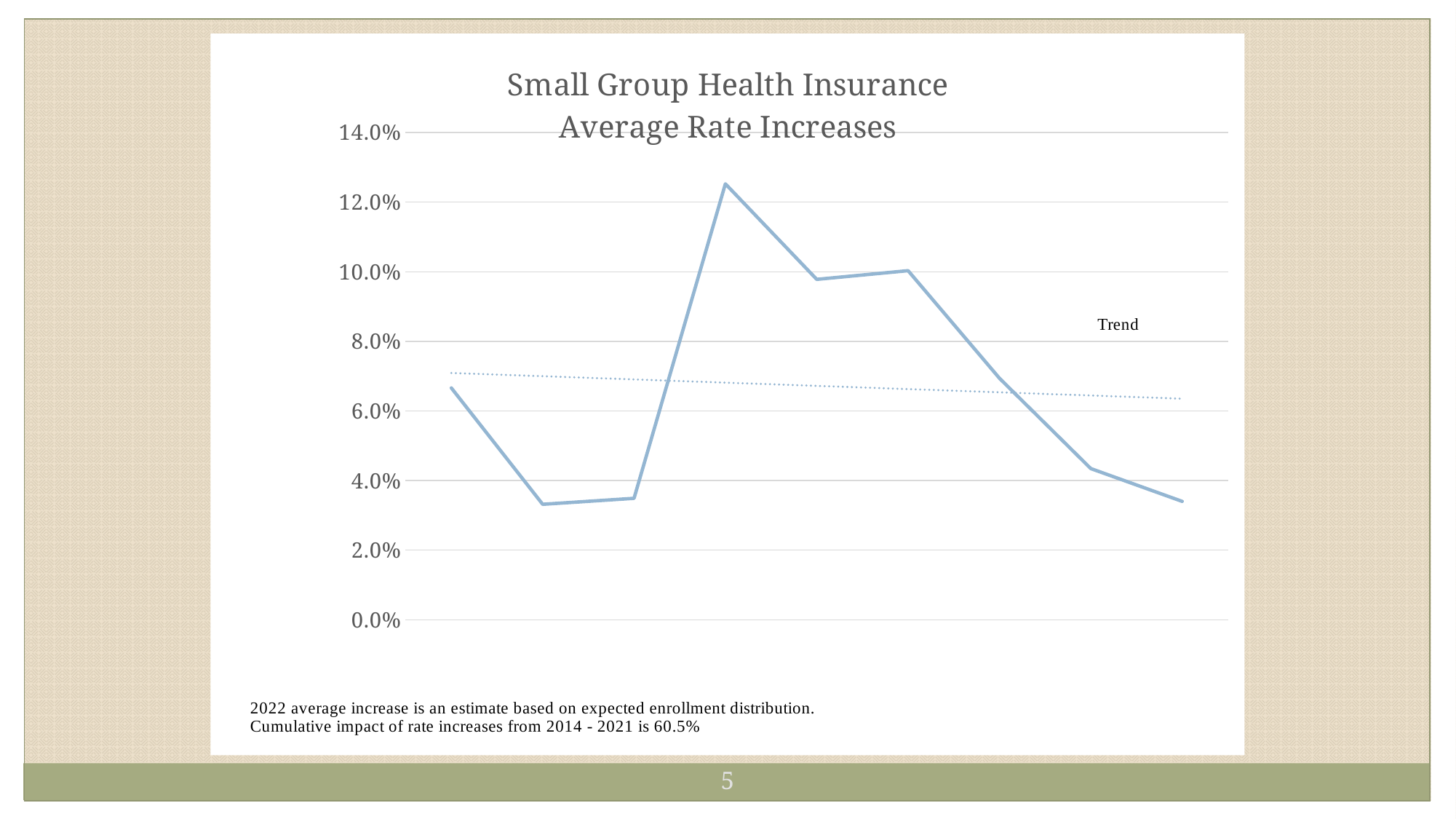
Do the values on the solid line rise or fall from the fourth point to the last point? fall Is the fourth point on the solid line higher or lower than the fifth point? higher What is the title of the chart? Small Group Health Insurance Average Rate Increases Is the last point on the solid line greater or less than 4.0%? less Is the lowest point on the solid line greater or less than 4.0%? less How many data points are plotted on the solid line? 9 Is the highest point on the solid line greater or less than 12.0%? greater Does the dotted trend line rise or fall from left to right? fall What is the highest value shown on the vertical axis? 14.0% What kind of chart is shown on the slide? line chart What label is shown next to the dotted line on the chart? Trend